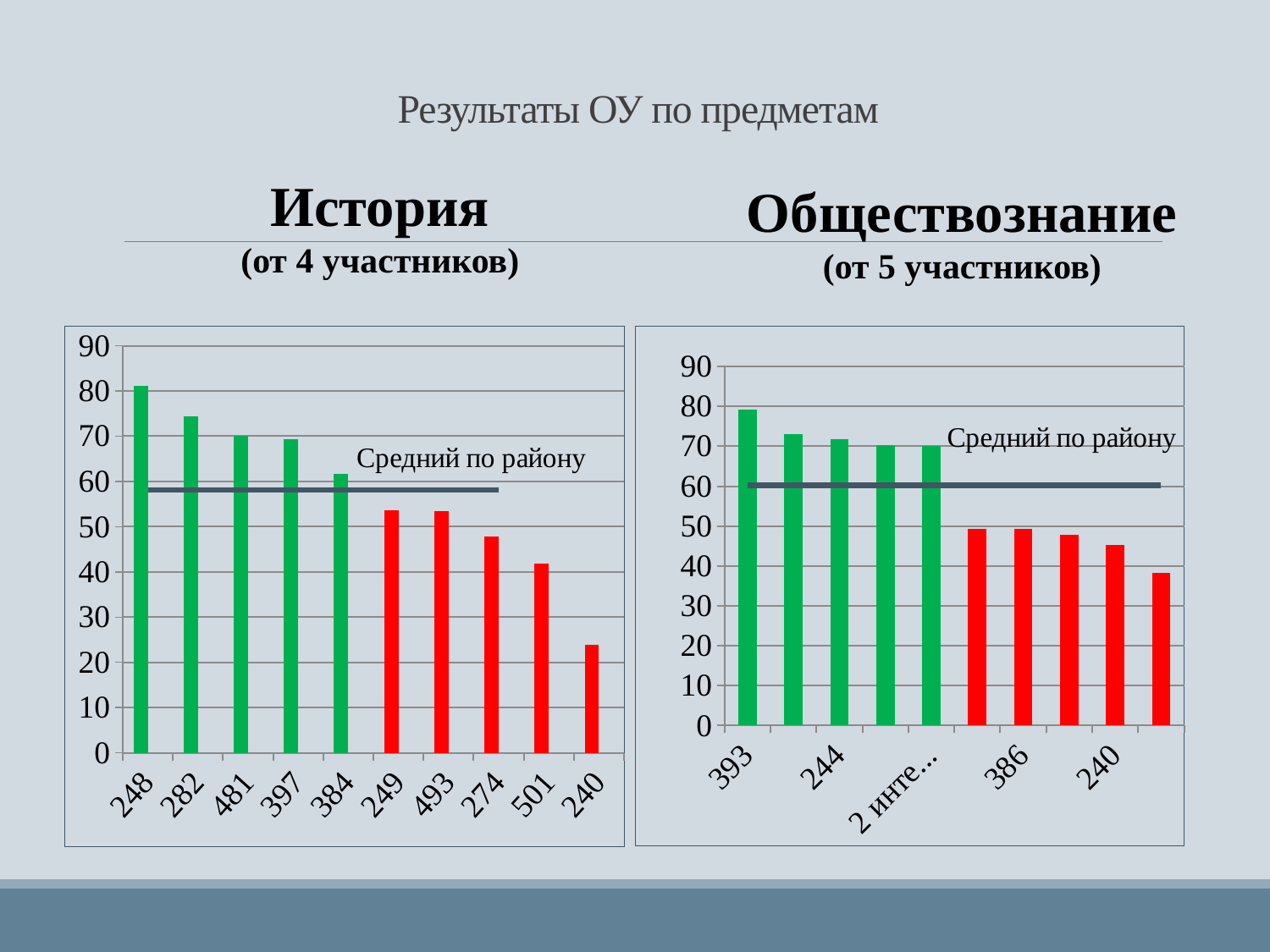
In the История (от 4 участников) chart, is the value for 240 greater or less than 30? less How many bars are plotted in the Обществознание (от 5 участников) chart? 10 What is the label of the horizontal line drawn across the Обществознание (от 5 участников) chart? Средний по району In the Обществознание (от 5 участников) chart, which is larger, the value for 244 or the value for 386? 244 In the История (от 4 участников) chart, is the value for 384 greater or less than 50? greater In the История (от 4 участников) chart, which category has the lowest bar? 240 What kind of chart is the История (от 4 участников) chart? bar chart How many bars are plotted in the История (от 4 участников) chart? 10 In the Обществознание (от 5 участников) chart, is the value for 393 greater or less than 70? greater In the История (от 4 участников) chart, which category has the highest bar? 248 In the История (от 4 участников) chart, which is larger, the value for 282 or the value for 274? 282 In the История (от 4 участников) chart, do the bar values rise or fall from left to right? fall